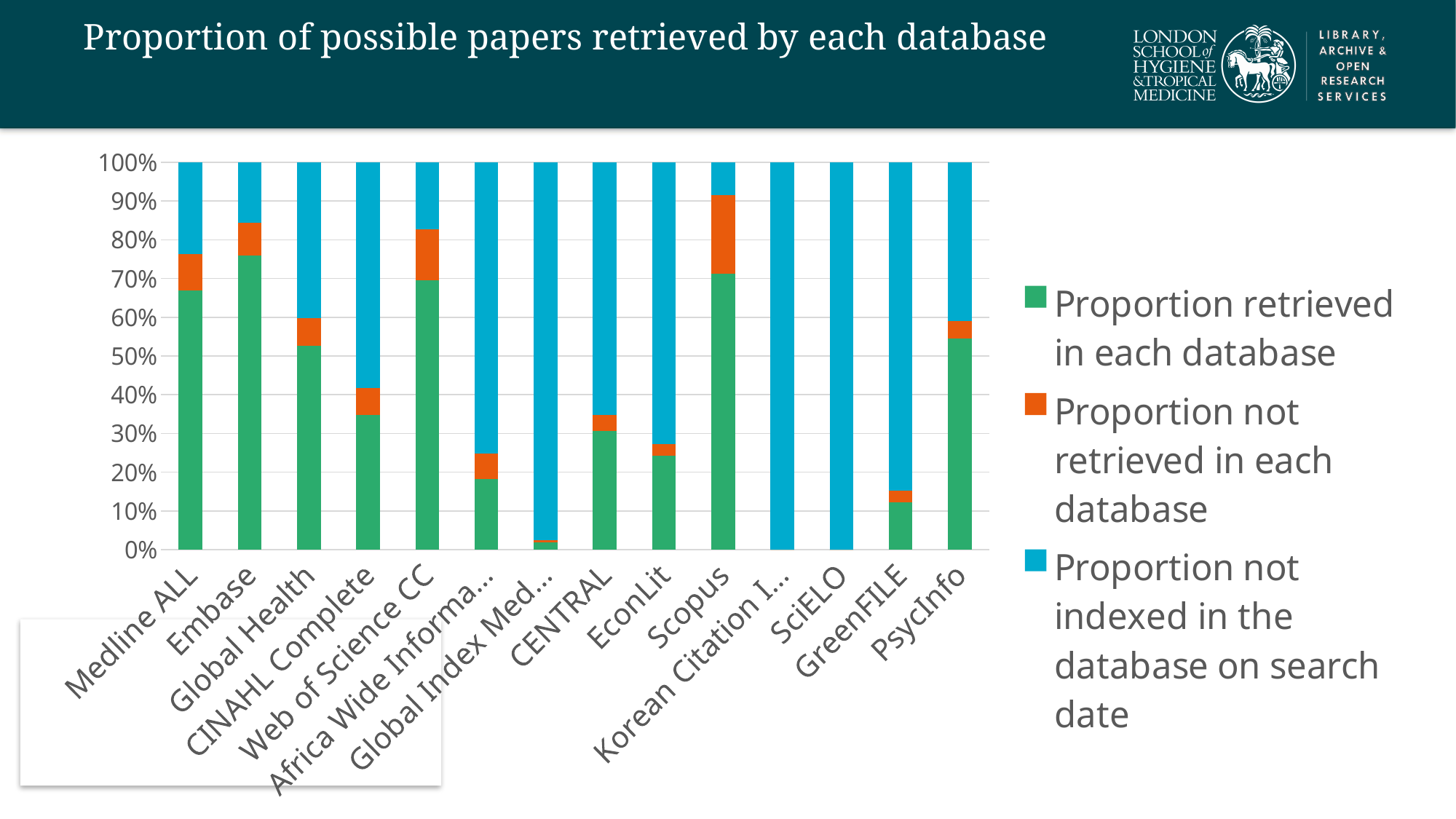
Is the proportion retrieved for Medline ALL greater or less than 60%? greater Which has a larger proportion retrieved, Web of Science CC or CINAHL Complete? Web of Science CC Which database has the highest proportion retrieved (green segment)? Embase Which database has the smallest proportion not indexed in the database on search date (blue segment)? Scopus How many databases (categories) are shown on the x axis? 14 Is the proportion retrieved for CINAHL Complete greater or less than 40%? less What kind of chart is shown on the slide? Stacked bar chart Which has a larger proportion retrieved, Medline ALL or Global Health? Medline ALL What is the title of the chart on the slide? Proportion of possible papers retrieved by each database Is the proportion retrieved for Scopus greater or less than 60%? greater How many series does the legend list? 3